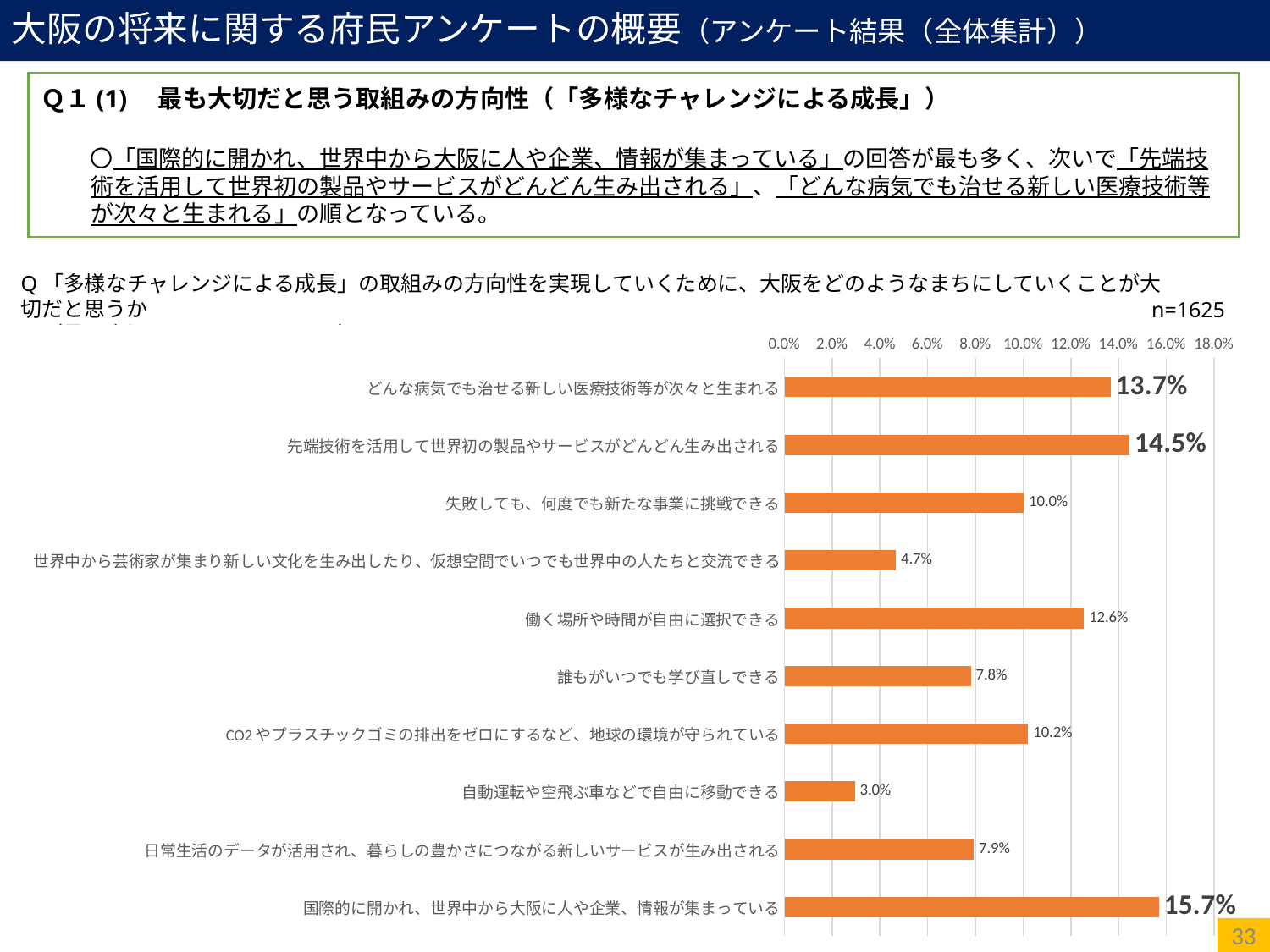
How many categories are shown in the chart? 10 What is the value for 「自動運転や空飛ぶ車などで自由に移動できる」? 3.0% Is the value for 「世界中から芸術家が集まり新しい文化を生み出したり、仮想空間でいつでも世界中の人たちと交流できる」 greater or less than 6.0%? less What is the value for 「働く場所や時間が自由に選択できる」? 12.6% What is the sample size (n) shown for the chart? n=1625 Which is larger, the value for 「誰もがいつでも学び直しできる」 or the value for 「日常生活のデータが活用され、暮らしの豊かさにつながる新しいサービスが生み出される」? 日常生活のデータが活用され、暮らしの豊かさにつながる新しいサービスが生み出される Which category has the highest value? 国際的に開かれ、世界中から大阪に人や企業、情報が集まっている What is the difference between the values for 「国際的に開かれ、世界中から大阪に人や企業、情報が集まっている」 and 「どんな病気でも治せる新しい医療技術等が次々と生まれる」? 2.0% What is the value for 「国際的に開かれ、世界中から大阪に人や企業、情報が集まっている」? 15.7% What is the value for 「先端技術を活用して世界初の製品やサービスがどんどん生み出される」? 14.5% Which category has the lowest value? 自動運転や空飛ぶ車などで自由に移動できる What kind of chart is shown on the slide? bar chart